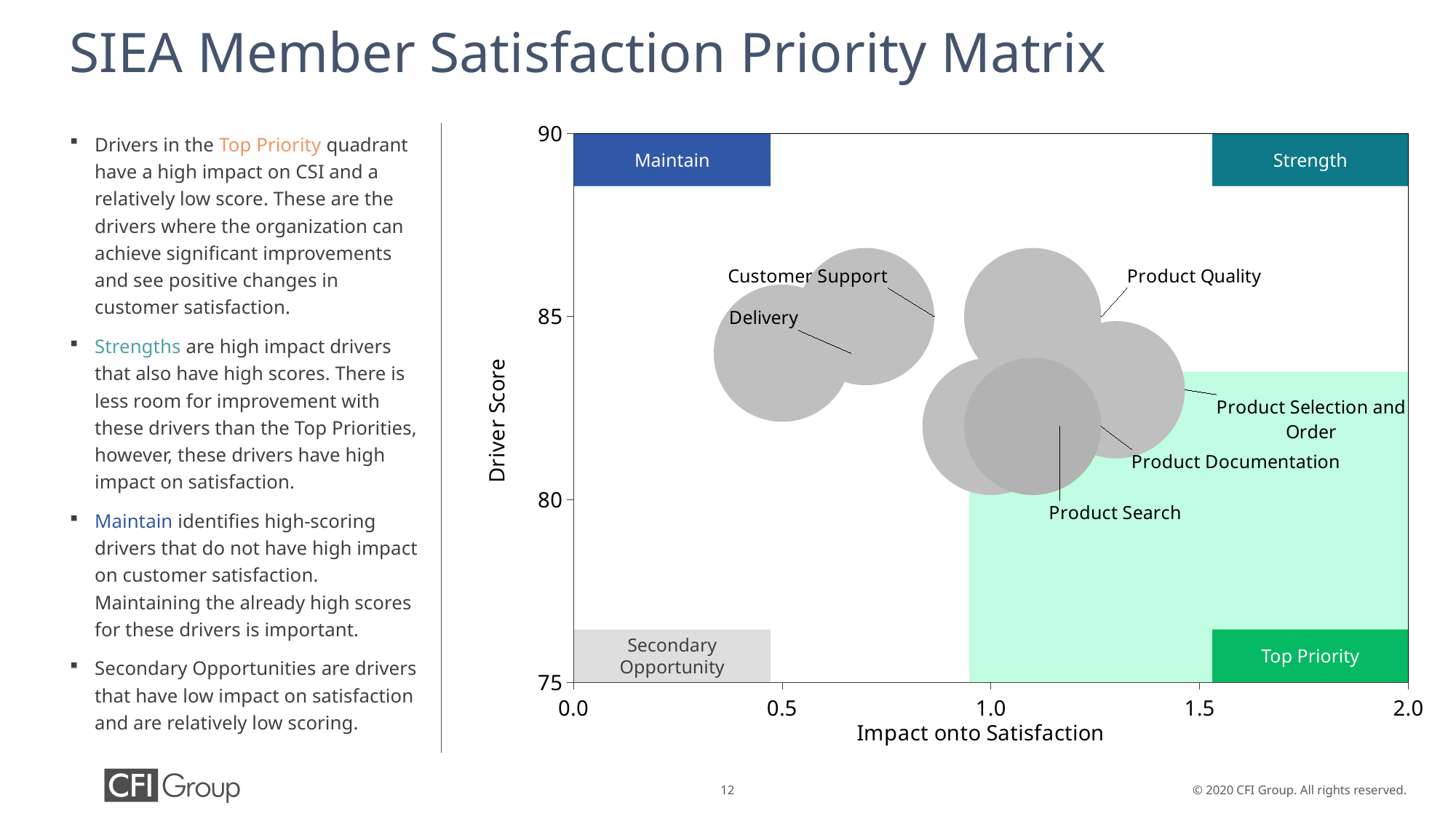
How many drivers are plotted as bubbles on the chart? 6 Which has a higher impact onto satisfaction, Delivery or Product Search? Product Search What is the label of the quadrant in the top-right corner of the chart? Strength Which driver has the highest impact onto satisfaction? Product Selection and Order Is the impact onto satisfaction for Delivery greater or less than 1.0? less Which driver has the lowest impact onto satisfaction? Delivery What is the label of the vertical axis? Driver Score What kind of chart is shown on the slide? Bubble chart Which has a higher driver score, Product Quality or Product Search? Product Quality Is the impact onto satisfaction for Product Selection and Order greater or less than 1.0? greater Is the driver score for Product Search greater or less than 80? greater